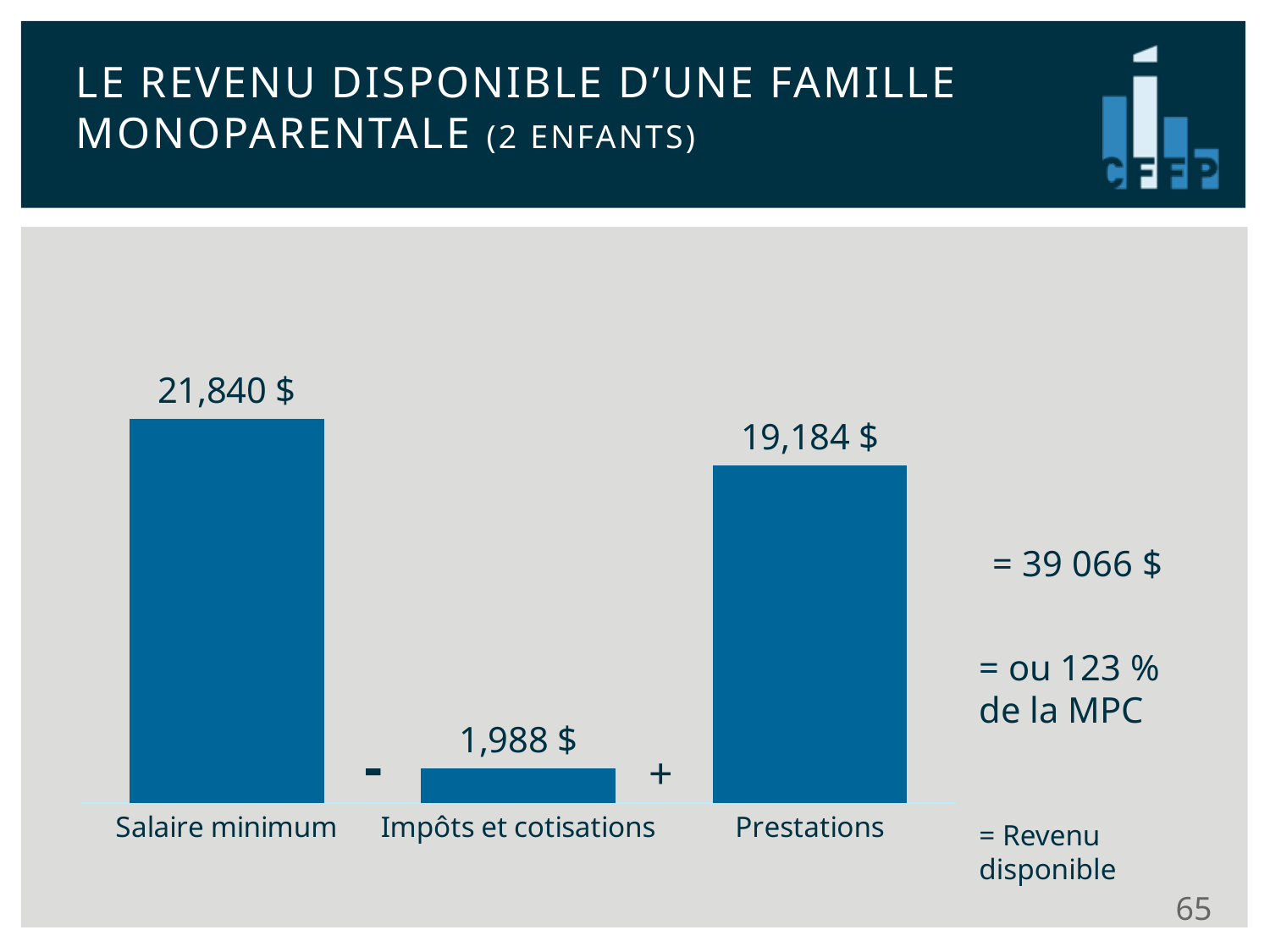
Which category has the highest value? Salaire minimum What kind of chart is shown on the slide? Bar chart What is the value for Salaire minimum? 21,840 $ What revenu disponible total is shown to the right of the chart? 39 066 $ What is the value for Prestations? 19,184 $ What is the difference between Salaire minimum and Prestations? 2,656 $ How many categories are shown in the chart? 3 Which is larger, Salaire minimum or Prestations? Salaire minimum Which category has the lowest value? Impôts et cotisations What is the value for Impôts et cotisations? 1,988 $ What percentage of the MPC does the revenu disponible represent, according to the slide? 123 % What is the difference between Prestations and Impôts et cotisations? 17,196 $